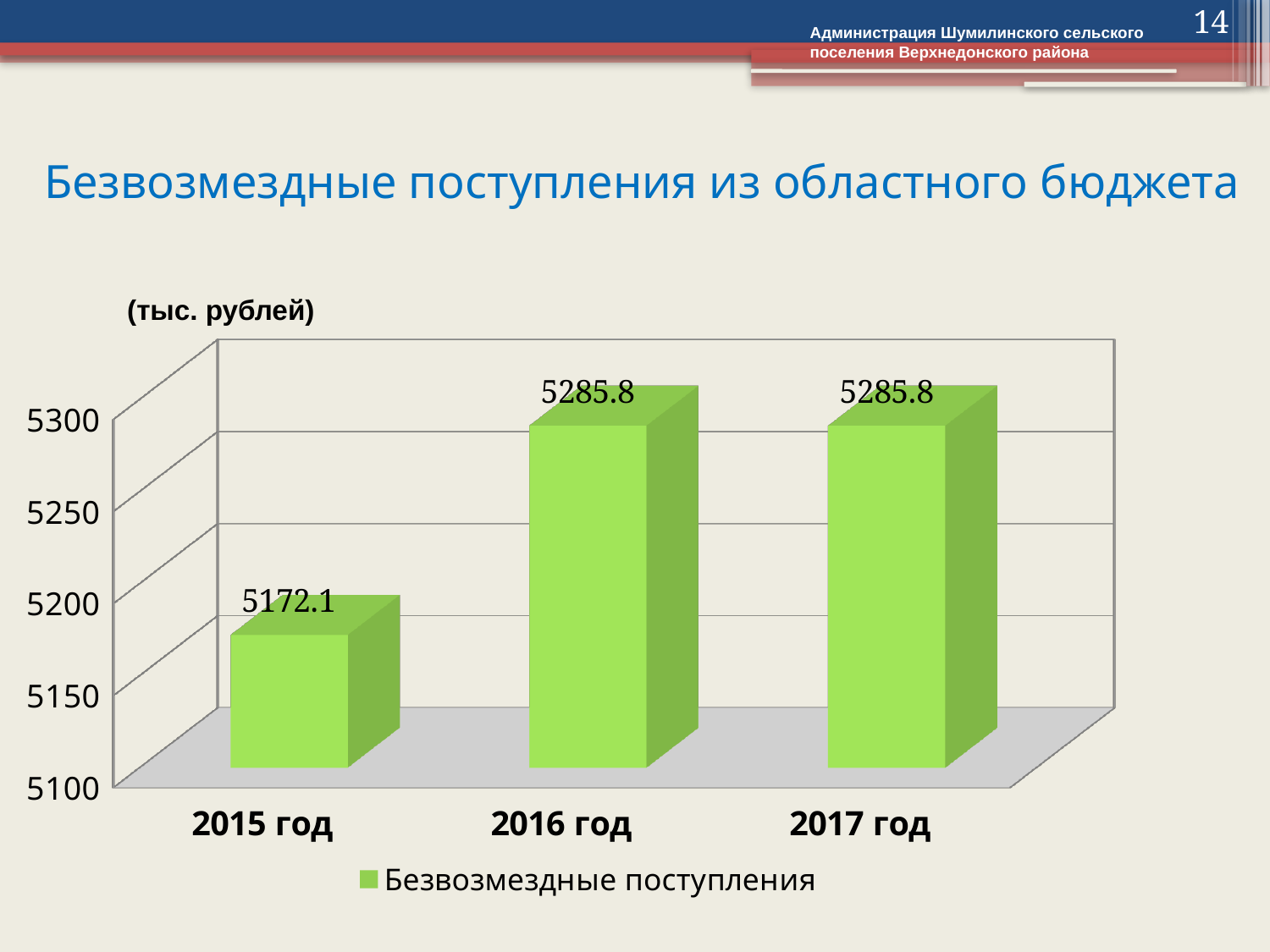
What kind of chart is shown on the slide? bar chart Which year has the lowest value? 2015 год What unit is indicated above the chart? тыс. рублей Is the value for 2016 год greater or less than 5250? greater What is the value for 2015 год? 5172.1 Is the value for 2015 год greater or less than 5200? less What is the difference between the values for 2016 год and 2015 год? 113.7 Which is larger, the value for 2015 год or the value for 2017 год? 2017 год How many categories are shown on the x axis? 3 What is the value for 2016 год? 5285.8 How many series does the legend list? 1 What is the value for 2017 год? 5285.8